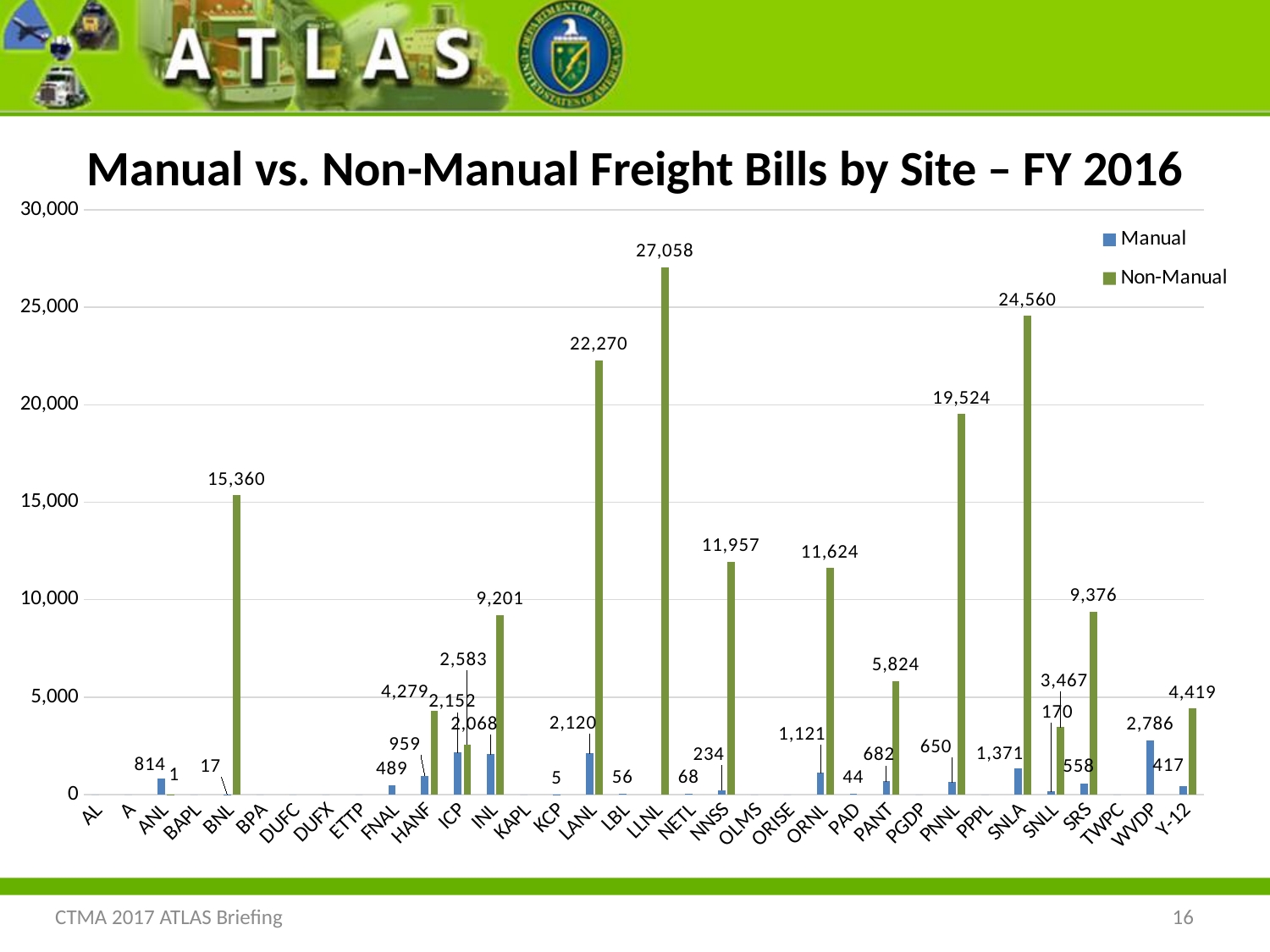
What is the title of the chart? Manual vs. Non-Manual Freight Bills by Site – FY 2016 How many series does the legend list? 2 What is the Manual value for ANL? 814 How many sites are shown on the x axis? 34 What is the Non-Manual value for LLNL? 27,058 What kind of chart is shown on the slide? Bar chart Which is larger, the Non-Manual value for NNSS or for ORNL? NNSS Which site has the highest Non-Manual value? LLNL What is the difference between the Non-Manual and Manual values for INL? 7,133 What is the Non-Manual value for PNNL? 19,524 What is the Non-Manual value for BNL? 15,360 What is the difference between the Non-Manual values for LLNL and LANL? 4,788